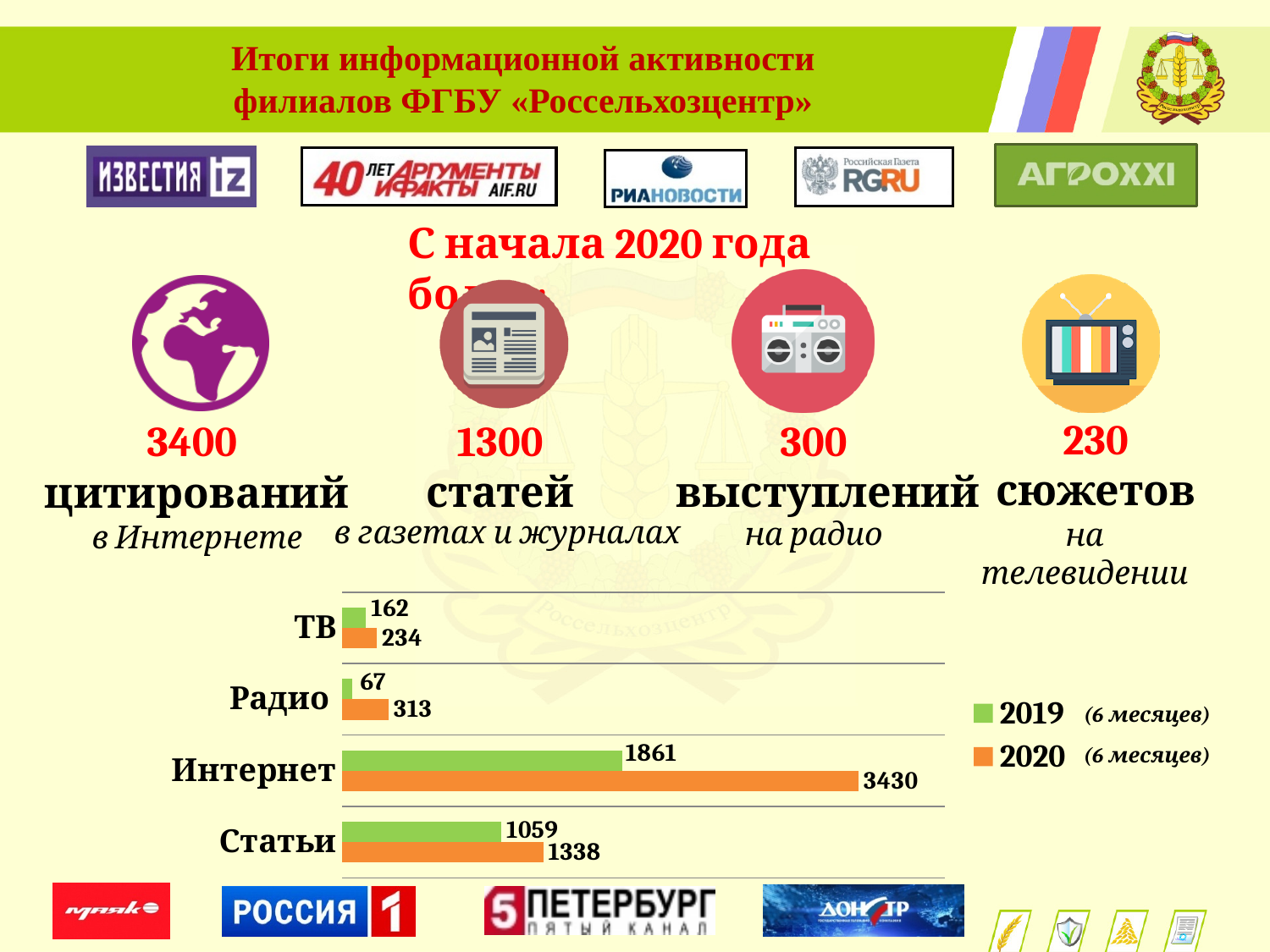
How many categories are shown in the bar chart? 4 Which category has the lowest 2019 value in the bar chart? Радио How many series does the legend of the bar chart list? 2 What is the 2020 value for ТВ in the bar chart? 234 What is the difference between the 2020 and 2019 values for Интернет? 1569 Which category has the highest 2020 value in the bar chart? Интернет What is the 2019 value for Статьи in the bar chart? 1059 What is the 2020 value for Интернет in the bar chart? 3430 What is the 2019 value for Радио in the bar chart? 67 What is the difference between the 2020 and 2019 values for Радио? 246 Which is larger for Статьи: the 2019 value or the 2020 value? 2020 What type of chart is shown on the slide? Bar chart